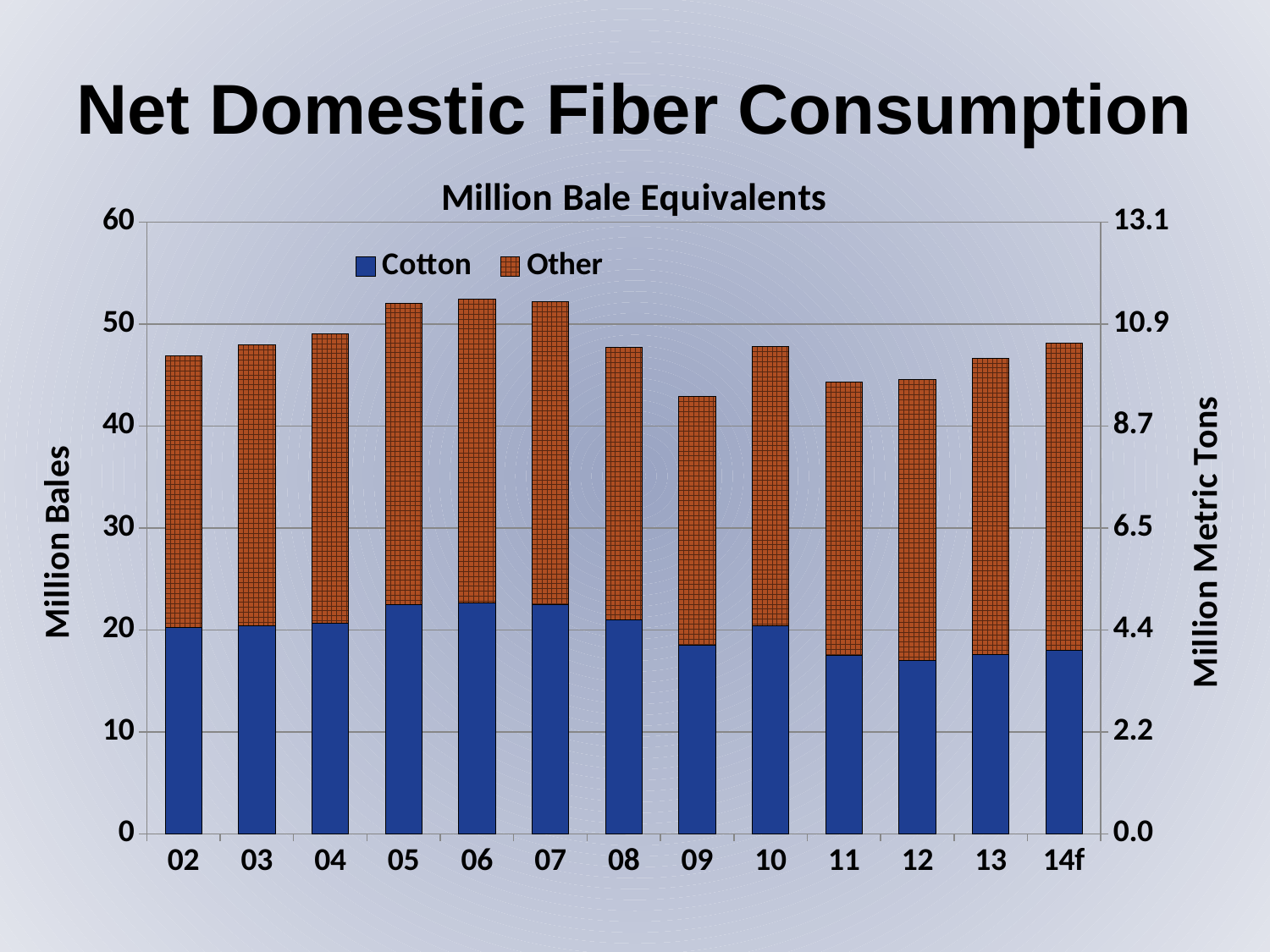
Which year has the larger total bar, 05 or 09? 05 What is the label on the right-hand vertical axis? Million Metric Tons How many years (categories) are shown on the x axis? 13 Is the total bar for 09 greater or less than 50 million bales? less Which year has the lowest total fiber consumption? 09 How many series does the legend list? 2 Is the Cotton value for 05 greater or less than 20 million bales? greater Which year has the larger Cotton value, 06 or 12? 06 Do the total bars rise or fall from 02 to 06? rise What kind of chart is shown on the slide? Stacked bar chart Is the Cotton value for 12 greater or less than 20 million bales? less